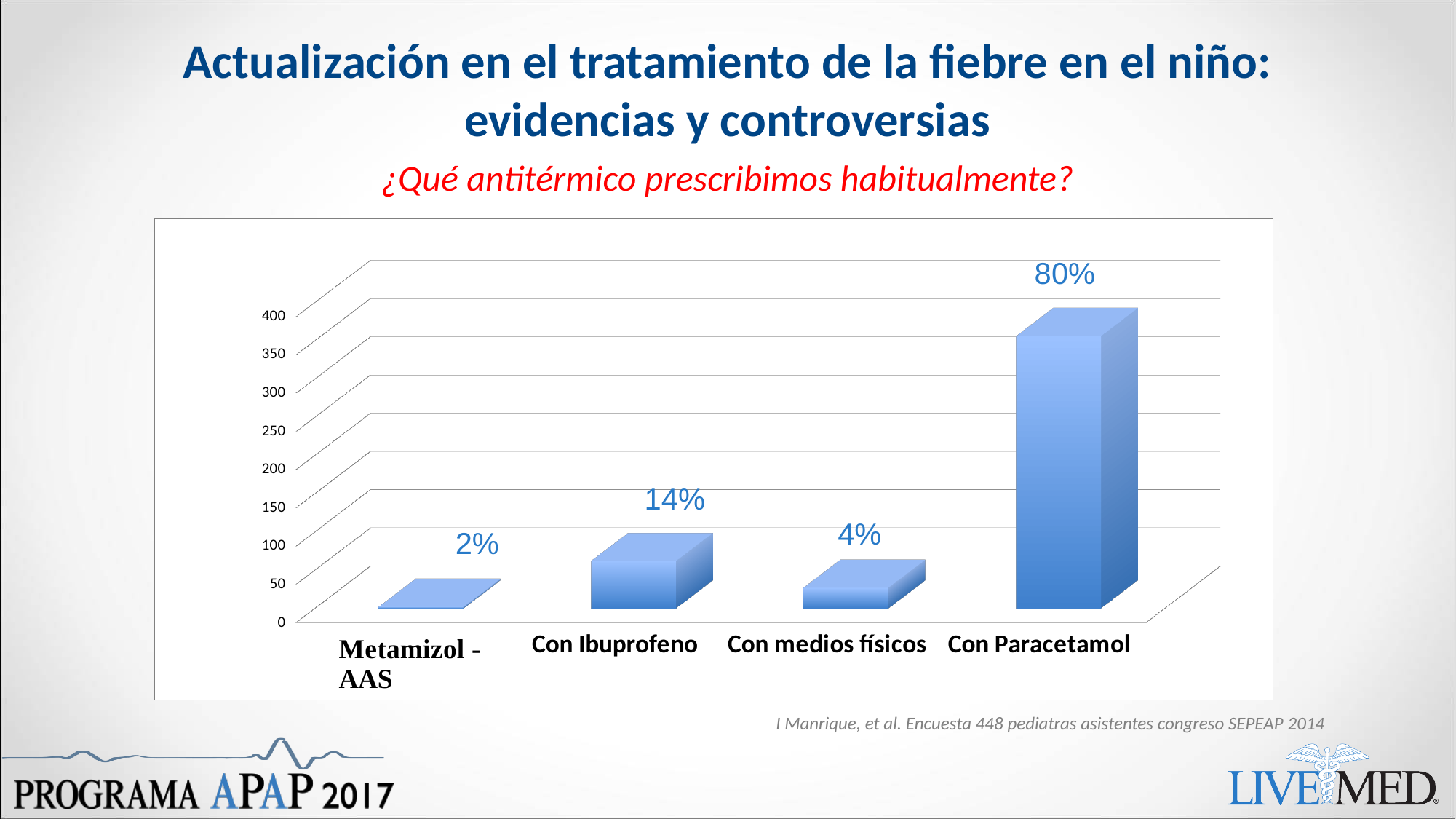
What is the difference in percentage points between Con Paracetamol and Con Ibuprofeno? 66% Which is larger, the value for Con Ibuprofeno or the value for Con medios físicos? Con Ibuprofeno Which category has the lowest value? Metamizol - AAS What percentage is shown for Con Paracetamol? 80% What kind of chart is shown on the slide? Bar chart What percentage is shown for Con Ibuprofeno? 14% Is the bar for Con Ibuprofeno greater or less than 100 on the vertical axis? less Which category has the highest value? Con Paracetamol How many categories are shown in the chart? 4 What percentage is shown for Metamizol - AAS? 2% What percentage is shown for Con medios físicos? 4% Is the bar for Con Paracetamol greater or less than 300 on the vertical axis? greater